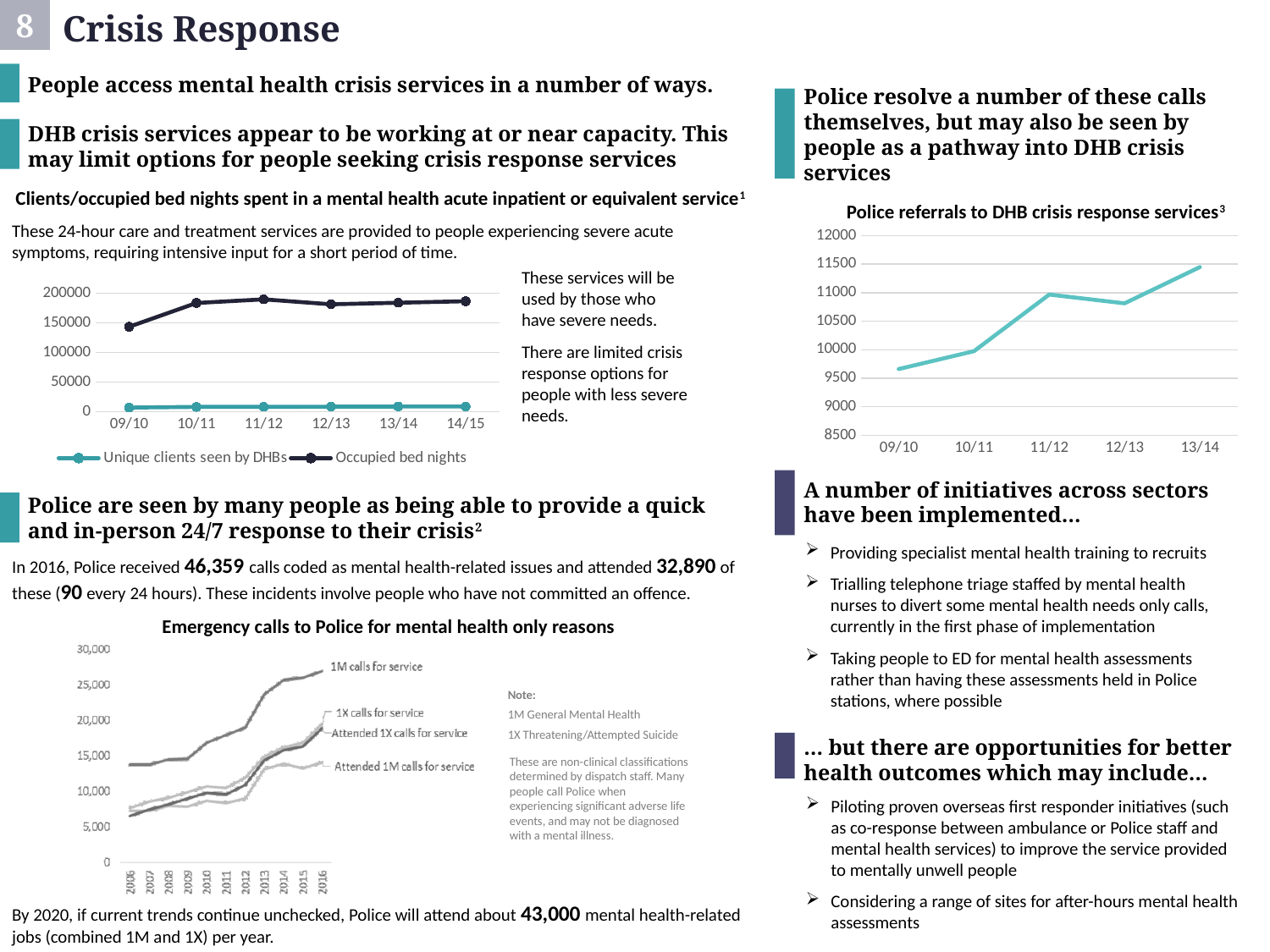
What kind of chart is the 'Police referrals to DHB crisis response services' chart? line chart In the 'Police referrals to DHB crisis response services' chart, which year has the lowest value? 09/10 In the 'Clients/occupied bed nights' chart, which series has the higher values, Unique clients seen by DHBs or Occupied bed nights? Occupied bed nights In the 'Police referrals to DHB crisis response services' chart, is the value for 13/14 greater or less than 11000? greater In the 'Clients/occupied bed nights' chart, in which year is Occupied bed nights lowest? 09/10 In the 'Emergency calls to Police for mental health only reasons' chart, do the 1M calls for service values rise or fall from 2006 to 2016? rise In the 'Emergency calls to Police for mental health only reasons' chart, which series has the highest value in 2016? 1M calls for service In the 'Clients/occupied bed nights' chart, is the value for Occupied bed nights in 10/11 greater or less than 150000? greater In the 'Police referrals to DHB crisis response services' chart, which year has the highest value? 13/14 How many series does the legend list in the 'Clients/occupied bed nights' chart on the left of the slide? 2 In the 'Police referrals to DHB crisis response services' chart, is the value for 09/10 greater or less than 10000? less How many years are plotted on the x axis of the 'Police referrals to DHB crisis response services' chart? 5